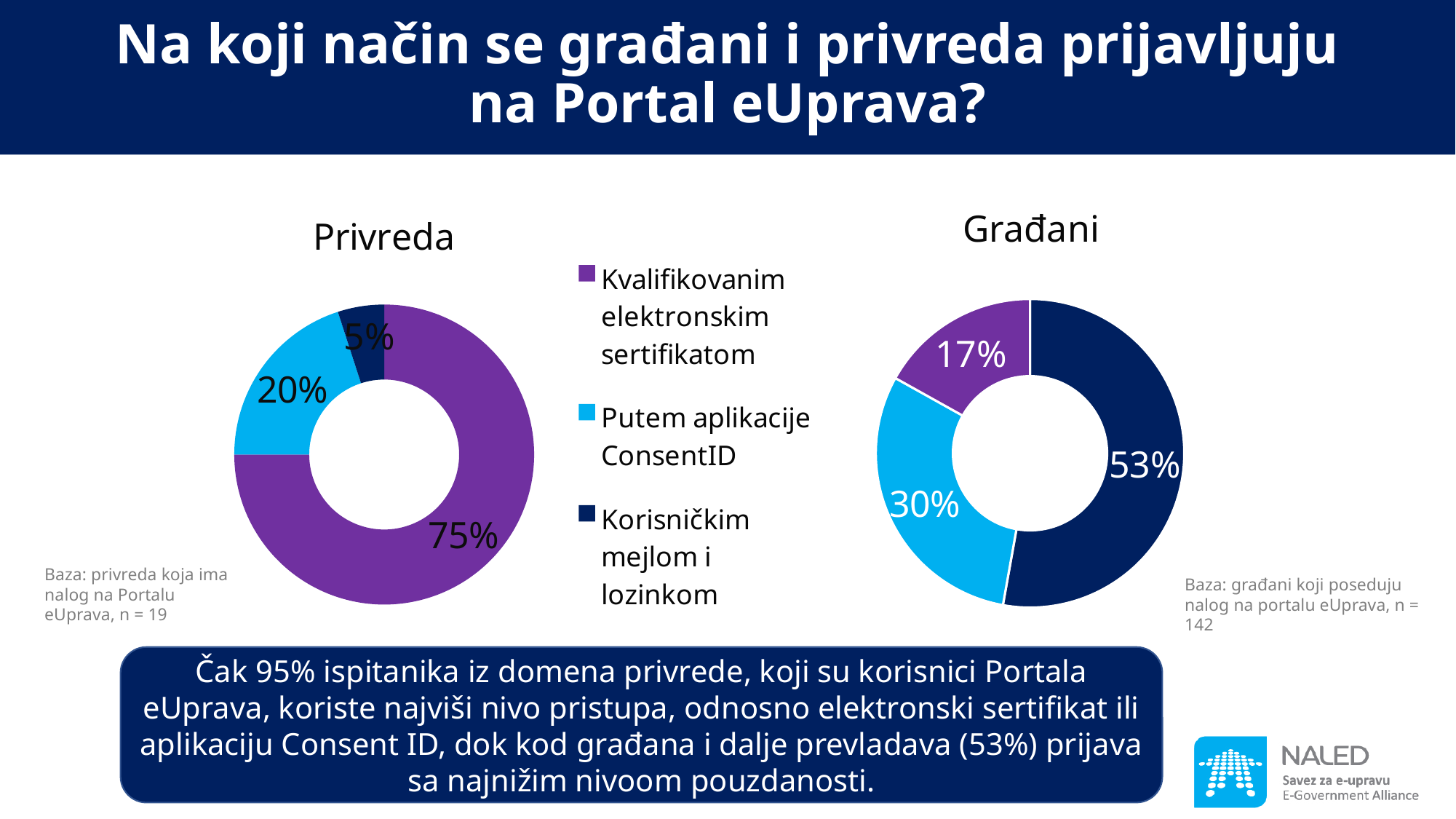
Which is larger: the share for Korisničkim mejlom i lozinkom in the Građani chart or in the Privreda chart? Građani In the Građani chart, which login method has the smallest share? Kvalifikovanim elektronskim sertifikatom In the Privreda chart, what share of respondents log in with a username, email and password (Korisničkim mejlom i lozinkom)? 5% What is the difference between the ConsentID share in the Građani chart and the ConsentID share in the Privreda chart? 10 percentage points How many slices does the Privreda chart have? 3 In the Privreda chart, what share of respondents log in with a qualified electronic certificate (Kvalifikovanim elektronskim sertifikatom)? 75% In the Građani chart, what share of respondents log in via the ConsentID application? 30% In the Građani chart, what share of respondents log in with a username, email and password (Korisničkim mejlom i lozinkom)? 53% Which colour represents Putem aplikacije ConsentID in the legend? Light blue What type of chart is used for Privreda and Građani? Pie (doughnut) chart In the Privreda chart, which login method has the largest share? Kvalifikovanim elektronskim sertifikatom How many entries does the legend list? 3